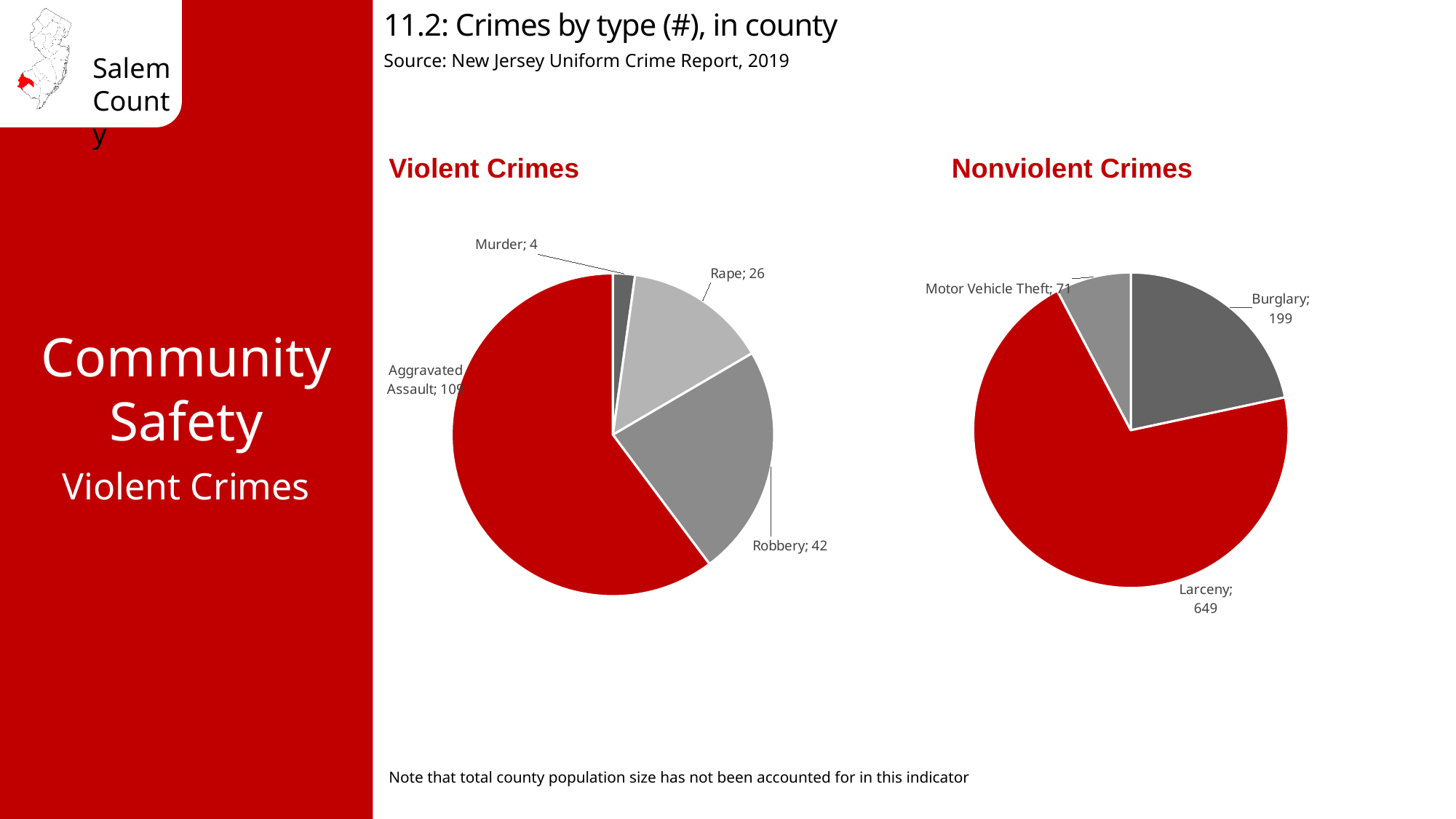
In the Violent Crimes pie chart, what is the value for Robbery? 42 In the Nonviolent Crimes pie chart, what is the value for Burglary? 199 In the Violent Crimes pie chart, what is the value for Rape? 26 How many crime types are shown in the Nonviolent Crimes pie chart? 3 In the Violent Crimes pie chart, which crime type has the smallest slice? Murder In the Violent Crimes pie chart, how many murders are shown? 4 In the Violent Crimes pie chart, what is the difference between Robbery and Rape? 16 In the Violent Crimes pie chart, which crime type has the largest slice? Aggravated Assault In the Nonviolent Crimes pie chart, which crime type has the smallest slice? Motor Vehicle Theft In the Nonviolent Crimes pie chart, what is the difference between Larceny and Burglary? 450 In the Nonviolent Crimes pie chart, what is the value for Larceny? 649 In the Nonviolent Crimes pie chart, which is larger, Burglary or Motor Vehicle Theft? Burglary